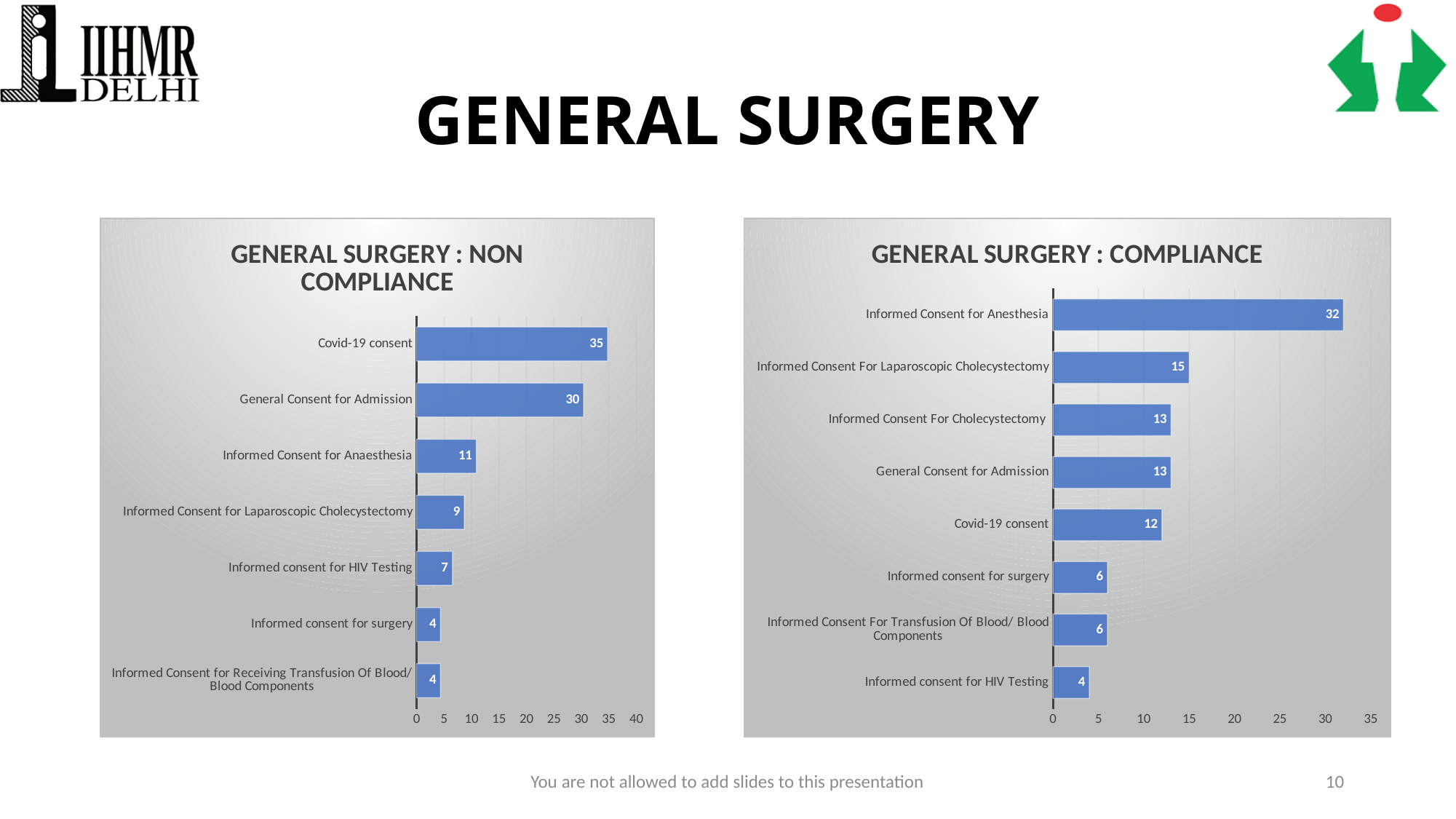
In the 'GENERAL SURGERY : COMPLIANCE' chart, which category has the lowest value? Informed consent for HIV Testing How many categories are shown in the 'GENERAL SURGERY : NON COMPLIANCE' chart? 7 In the 'GENERAL SURGERY : NON COMPLIANCE' chart, what is the value for Covid-19 consent? 35 How many categories are shown in the 'GENERAL SURGERY : COMPLIANCE' chart? 8 In the 'GENERAL SURGERY : NON COMPLIANCE' chart, which is larger: Informed Consent for Anaesthesia or Informed consent for HIV Testing? Informed Consent for Anaesthesia In the 'GENERAL SURGERY : NON COMPLIANCE' chart, what is the difference between Covid-19 consent and General Consent for Admission? 5 In the 'GENERAL SURGERY : COMPLIANCE' chart, what is the value for Informed Consent for Anesthesia? 32 What type of chart is the 'GENERAL SURGERY : COMPLIANCE' chart? Bar chart In the 'GENERAL SURGERY : NON COMPLIANCE' chart, what is the value for Informed consent for surgery? 4 In the 'GENERAL SURGERY : NON COMPLIANCE' chart, which category has the highest value? Covid-19 consent In the 'GENERAL SURGERY : COMPLIANCE' chart, is the value for Covid-19 consent greater or less than 10? greater In the 'GENERAL SURGERY : COMPLIANCE' chart, what is the difference between Informed Consent for Anesthesia and Informed Consent For Laparoscopic Cholecystectomy? 17